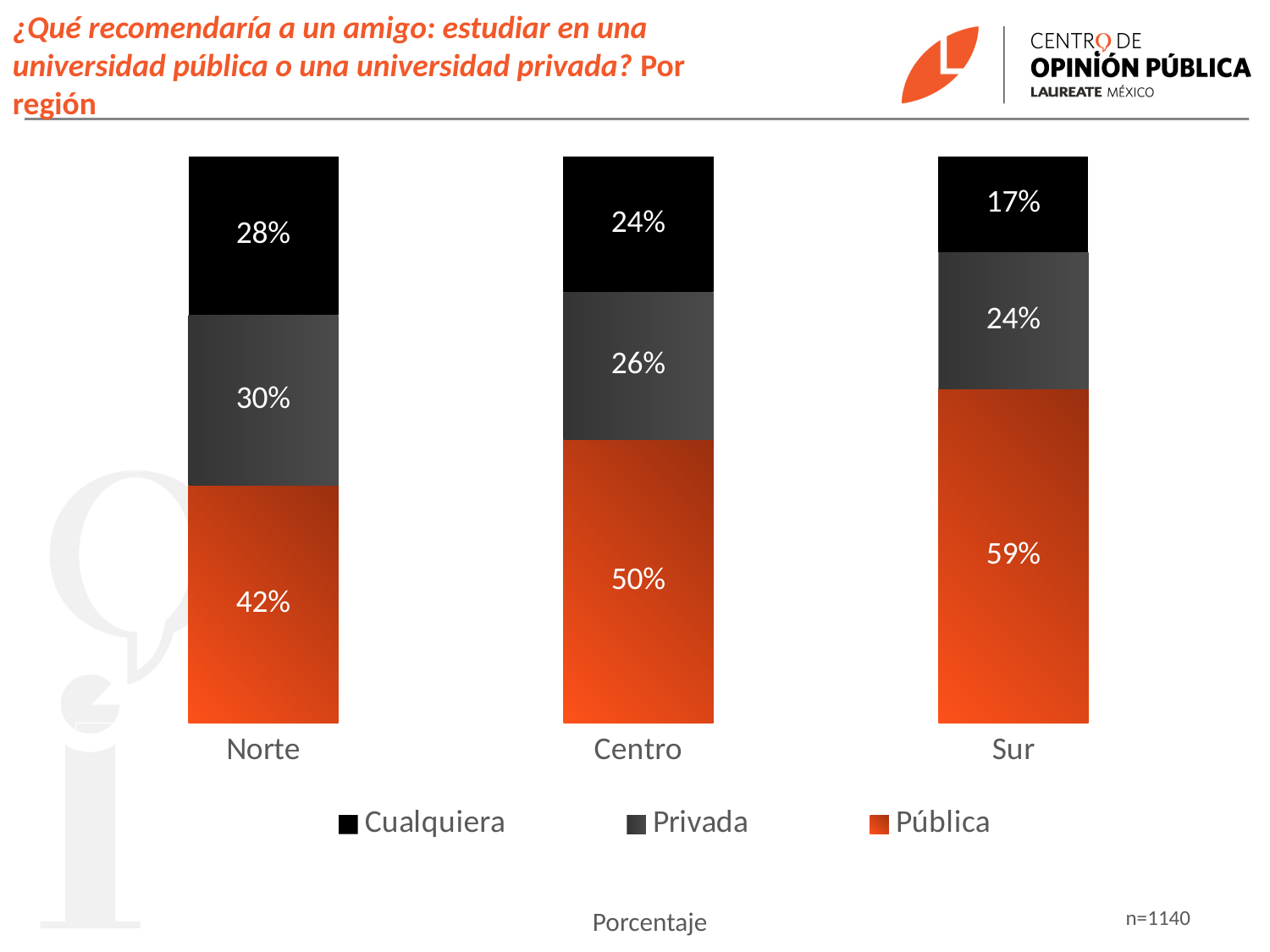
What kind of chart is shown on the slide? Stacked bar chart Which is larger in the Norte region: Privada or Cualquiera? Privada What percentage of respondents in Norte recommend a public university (Pública)? 42% How many regions are shown on the x axis? 3 What is the value for Privada in the Centro region? 26% Which region has the highest value for Pública? Sur Which region has the lowest value for Cualquiera? Sur Does the Pública value rise or fall moving from Norte to Centro to Sur? Rises What is the difference between the Pública values for Sur and Norte? 17 percentage points What is the value for Cualquiera in the Sur region? 17% What is the sample size (n) shown on the slide? n=1140 How many series does the legend list? 3